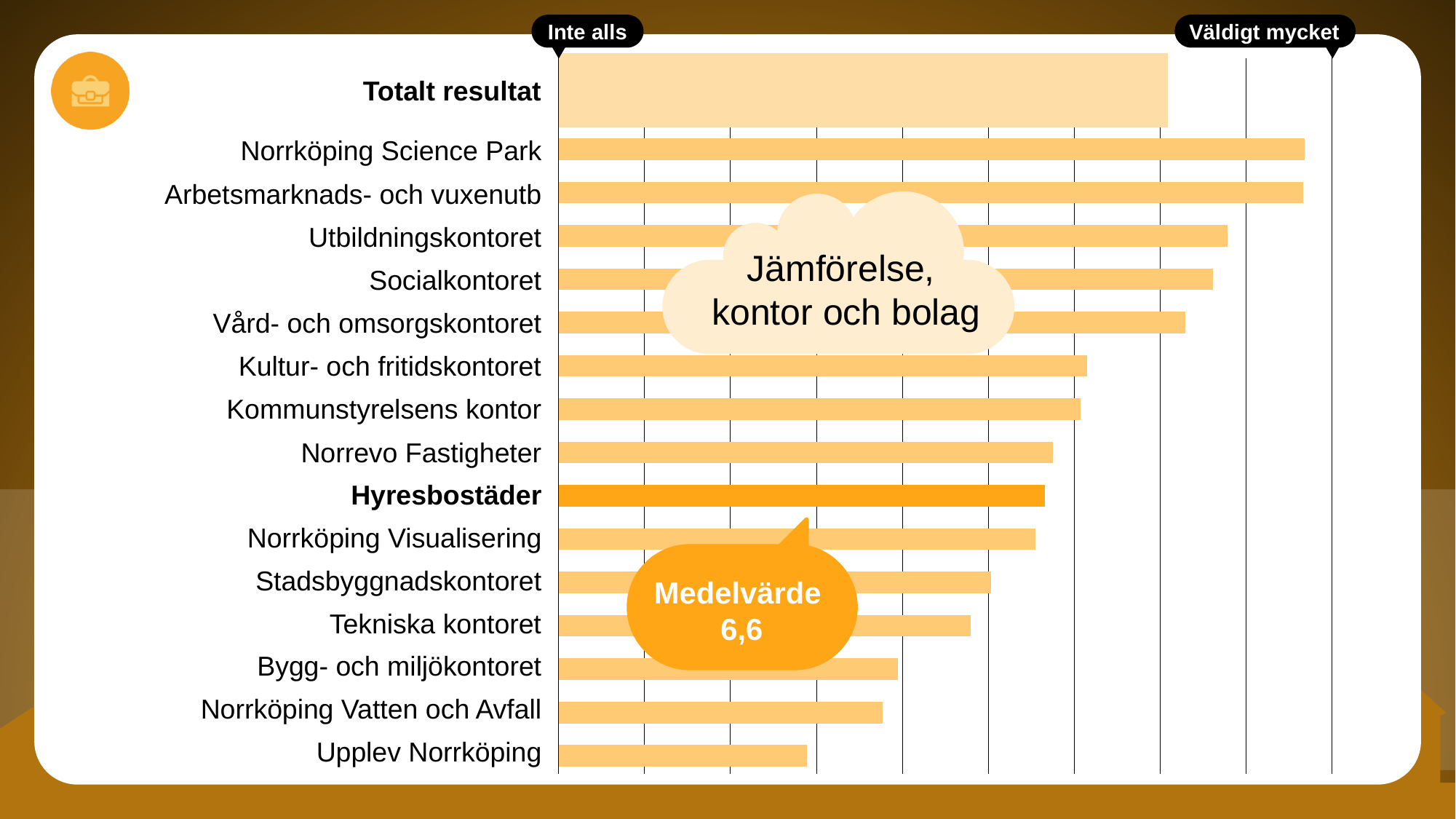
What title is shown in the cloud shape on the chart? Jämförelse, kontor och bolag What are the two labels at the ends of the horizontal axis? Inte alls and Väldigt mycket Which bar is longer: Vård- och omsorgskontoret or Kultur- och fritidskontoret? Vård- och omsorgskontoret What kind of chart is shown on the slide? bar chart How many categories are listed below 'Totalt resultat' in the chart? 15 Which bar is longer: Norrköping Science Park or Stadsbyggnadskontoret? Norrköping Science Park Which bar is longer: Bygg- och miljökontoret or Kommunstyrelsens kontor? Kommunstyrelsens kontor Which category has the shortest bar in the chart? Upplev Norrköping Do the bars get longer or shorter going from Norrköping Science Park down to Upplev Norrköping? shorter What value does the 'Medelvärde' callout show for the highlighted Hyresbostäder bar? 6,6